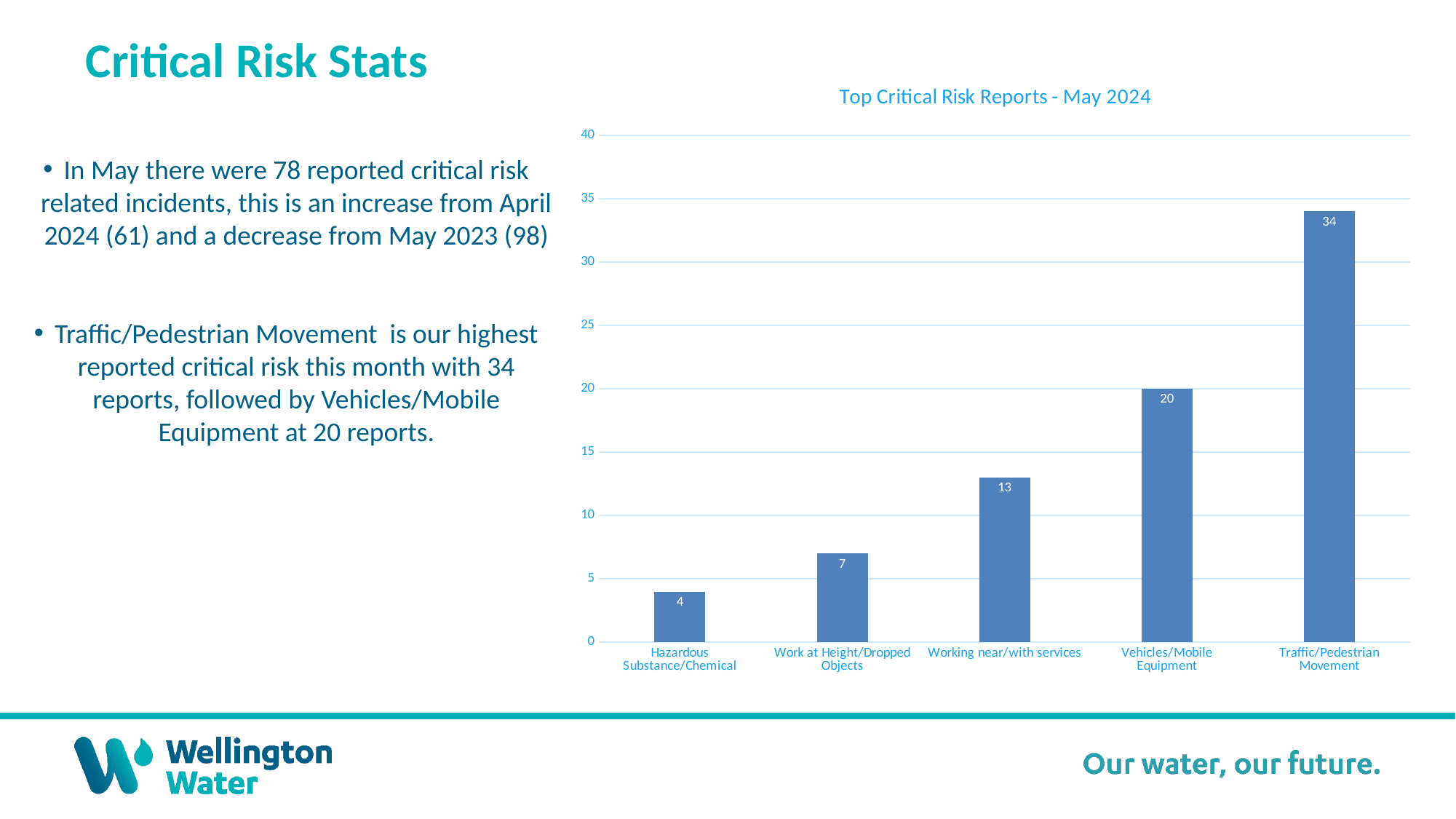
Which category has the lowest value? Hazardous Substance/Chemical What is the value for Vehicles/Mobile Equipment? 20 What is the title of the chart? Top Critical Risk Reports - May 2024 What is the difference between Traffic/Pedestrian Movement and Vehicles/Mobile Equipment? 14 What is the value for Working near/with services? 13 What kind of chart is shown? bar chart What is the value for Traffic/Pedestrian Movement? 34 How many categories are shown on the x axis? 5 Which is larger, Work at Height/Dropped Objects or Working near/with services? Working near/with services What is the value for Hazardous Substance/Chemical? 4 Is the value for Vehicles/Mobile Equipment greater or less than 15? greater Which category has the highest value? Traffic/Pedestrian Movement